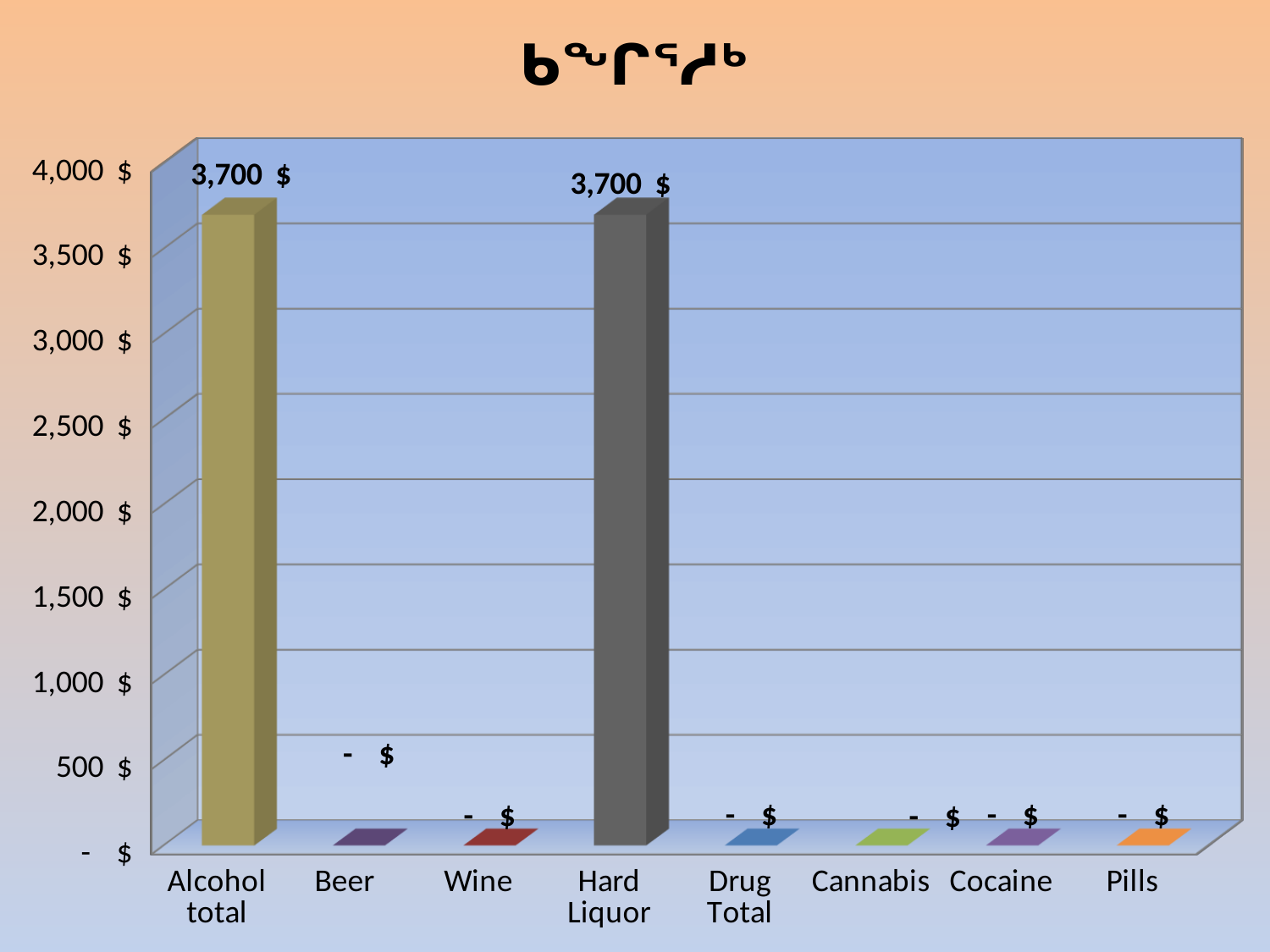
What is the value shown for Beer? - $ Which is larger, the value for Hard Liquor or the value for Wine? Hard Liquor What is the value shown for Drug Total? - $ What is the highest tick value shown on the vertical axis? 4,000 $ What is the value shown for Hard Liquor? 3,700 $ Which is larger, the value for Alcohol total or the value for Beer? Alcohol total Is the value for Alcohol total greater or less than 4,000 $? less What is the value shown for Alcohol total? 3,700 $ Is the value for Hard Liquor greater or less than 3,000 $? greater How many categories are shown on the x axis? 8 What kind of chart is shown on the slide? bar chart How many categories have a value labelled "- $"? 6